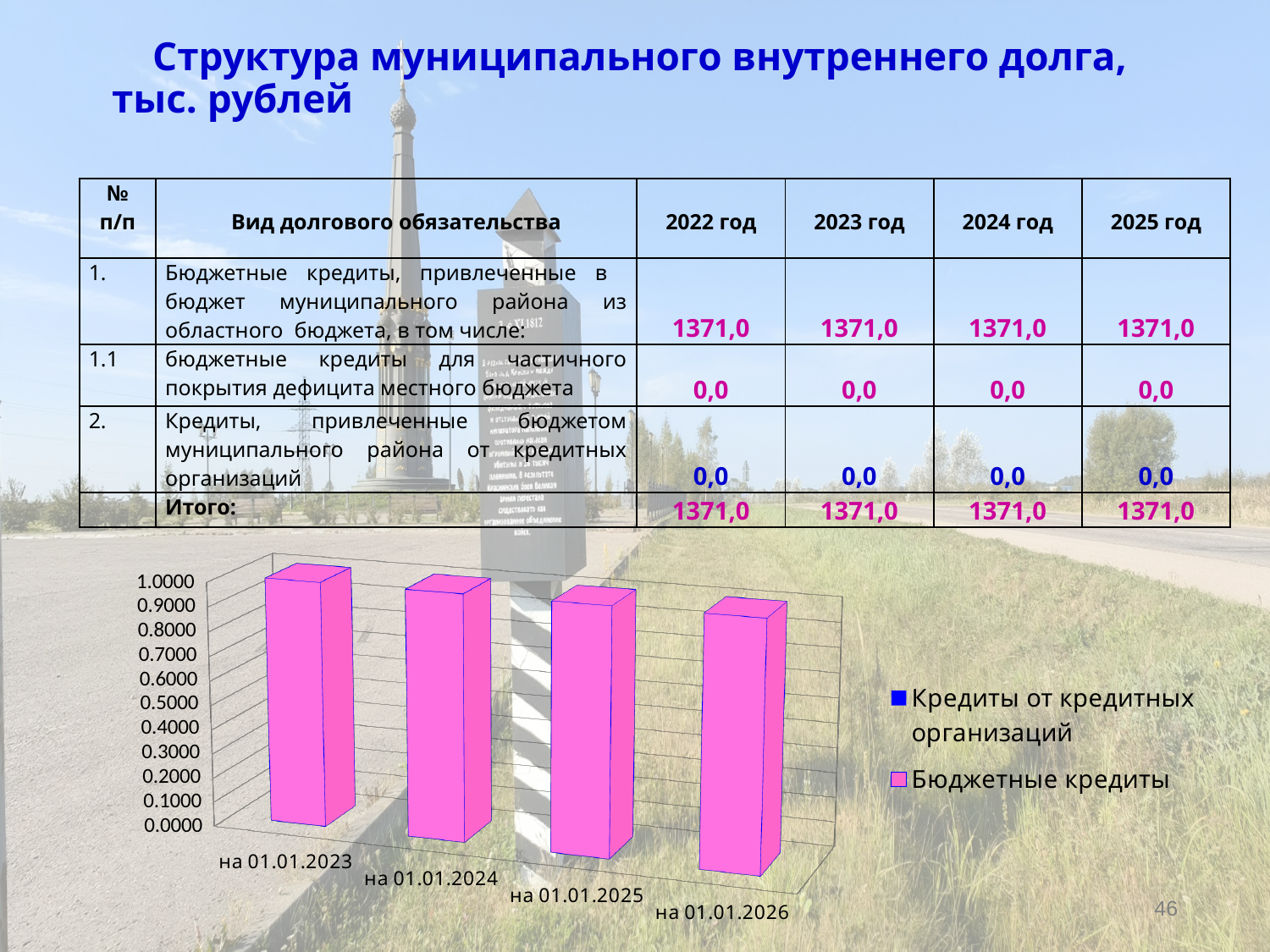
What kind of chart is shown on the slide? bar chart Is the value for на 01.01.2026 greater or less than 0.5000? greater How many series does the chart legend list? 2 What is the first category label on the x axis of the chart? на 01.01.2023 Is the value for на 01.01.2023 greater or less than 0.5000? greater What is the last category label on the x axis of the chart? на 01.01.2026 What is the maximum value shown on the chart's vertical axis? 1.0000 Is the value for на 01.01.2025 greater or less than 0.5000? greater How many categories (dates) are shown along the x axis of the chart? 4